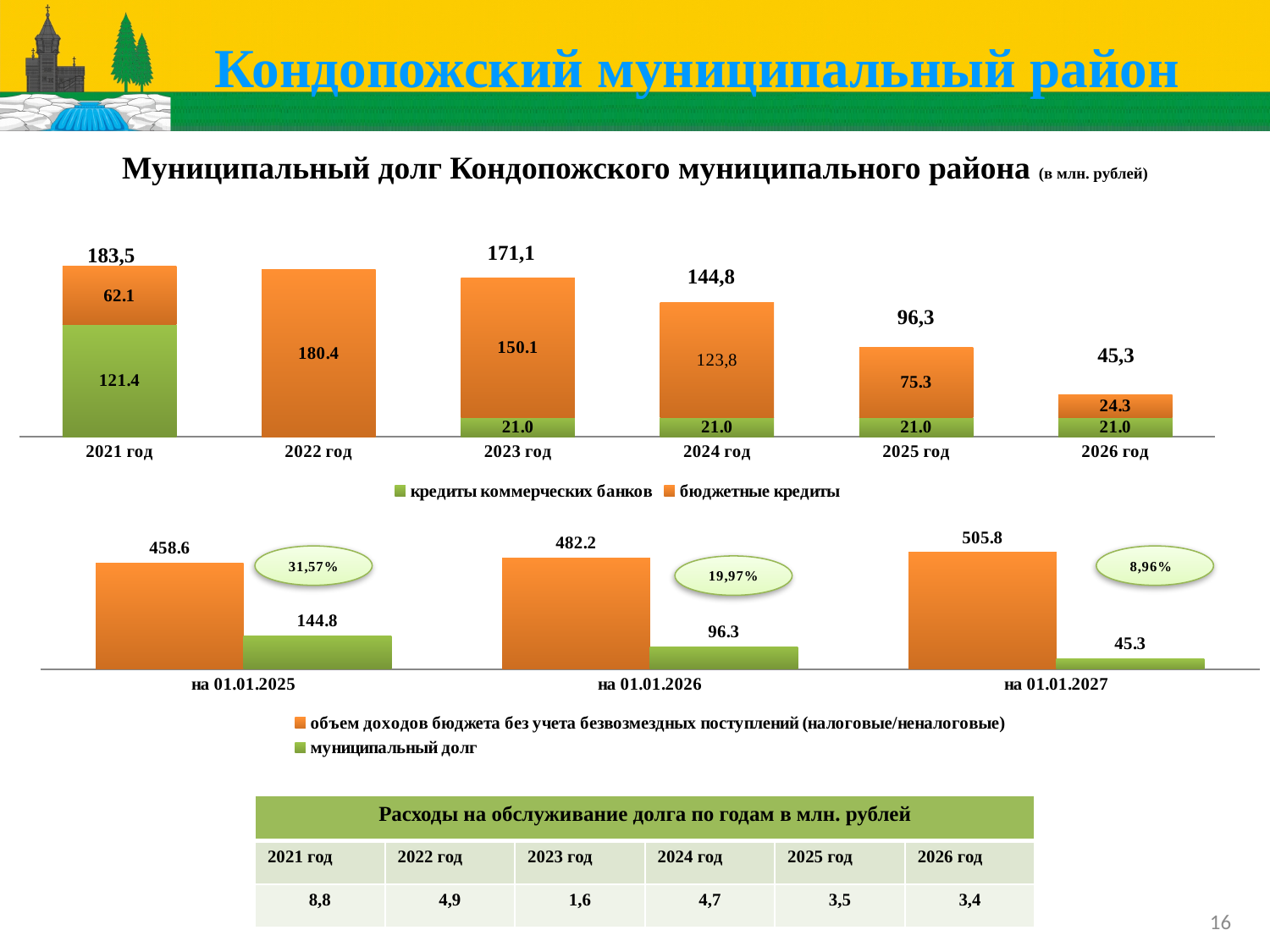
In the top chart, how many series does the legend list? 2 In the top chart, how many year categories are shown on the x axis? 6 In the bottom chart, what percentage is shown in the oval next to на 01.01.2026? 19,97% In the bottom chart, what is the difference between объем доходов бюджета and муниципальный долг for на 01.01.2025? 313.8 In the top chart, what is the value of кредиты коммерческих банков for 2021 год? 121.4 In the top chart, what is the value of бюджетные кредиты for 2021 год? 62.1 In the top chart, what is the value of бюджетные кредиты for 2025 год? 75.3 In the top chart, do the total debt values rise or fall from 2021 год to 2026 год? fall In the bottom chart, what is the value of муниципальный долг for на 01.01.2027? 45.3 In the top chart, which year has the lowest total municipal debt? 2026 год In the top chart, what is the total labelled above the stacked bar for 2023 год? 171,1 In the bottom chart, what is the value of объем доходов бюджета без учета безвозмездных поступлений for на 01.01.2026? 482.2